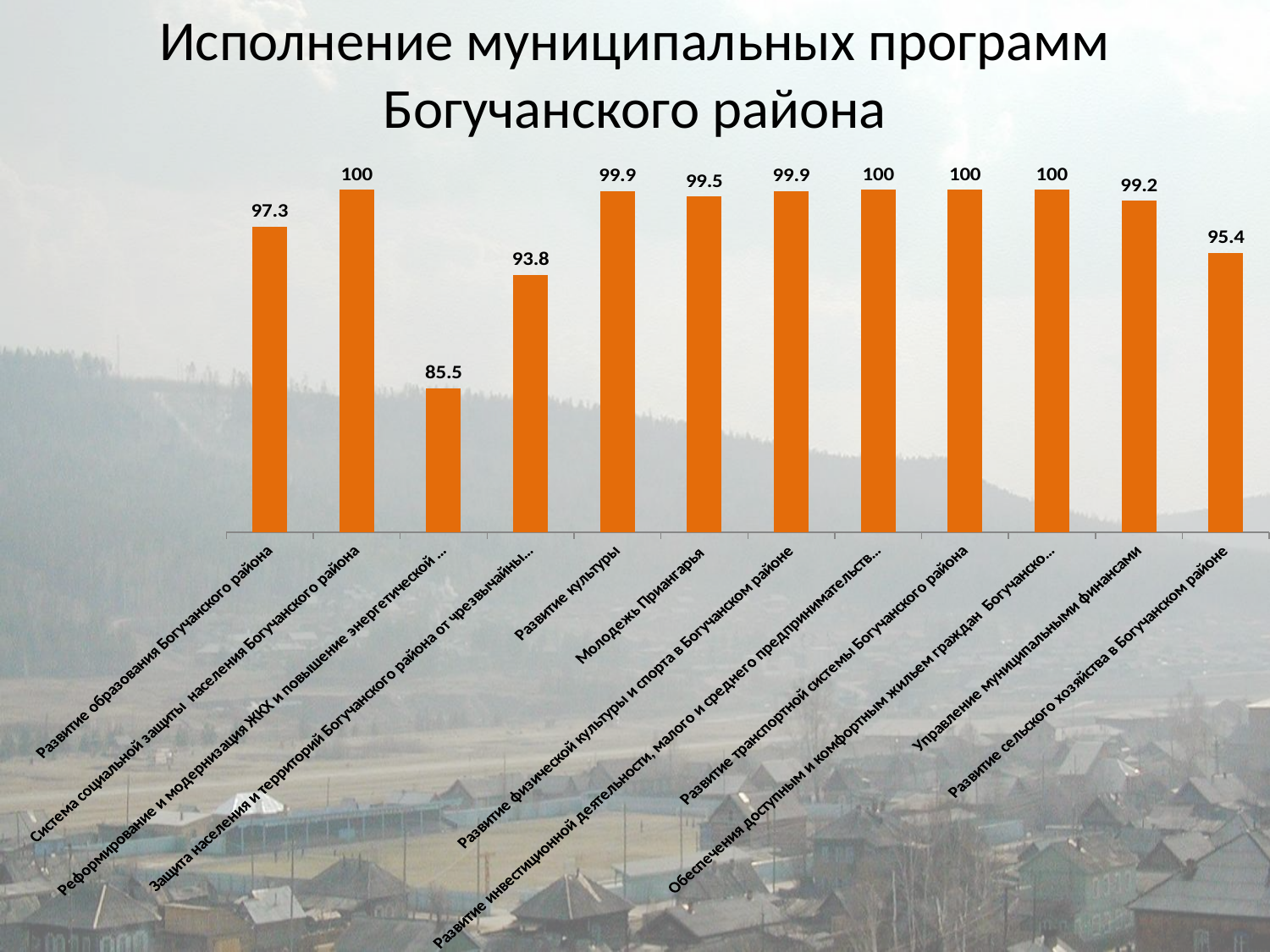
What kind of chart is shown on the slide? Bar chart How many programs have a value of 100? 4 What is the value for Развитие образования Богучанского района? 97.3 What is the value for Развитие сельского хозяйства в Богучанском районе? 95.4 Which is larger: the value for Защита населения и территорий Богучанского района or the value for Молодежь Приангарья? Молодежь Приангарья What is the value for Управление муниципальными финансами? 99.2 What is the difference between the values for Развитие образования Богучанского района and Развитие сельского хозяйства в Богучанском районе? 1.9 Which program has the lowest value? Реформирование и модернизация ЖКХ и повышение энергетической ... What is the value for Молодежь Приангарья? 99.5 How many bars are shown in the chart? 12 What is the title of the slide? Исполнение муниципальных программ Богучанского района What is the value for Развитие культуры? 99.9